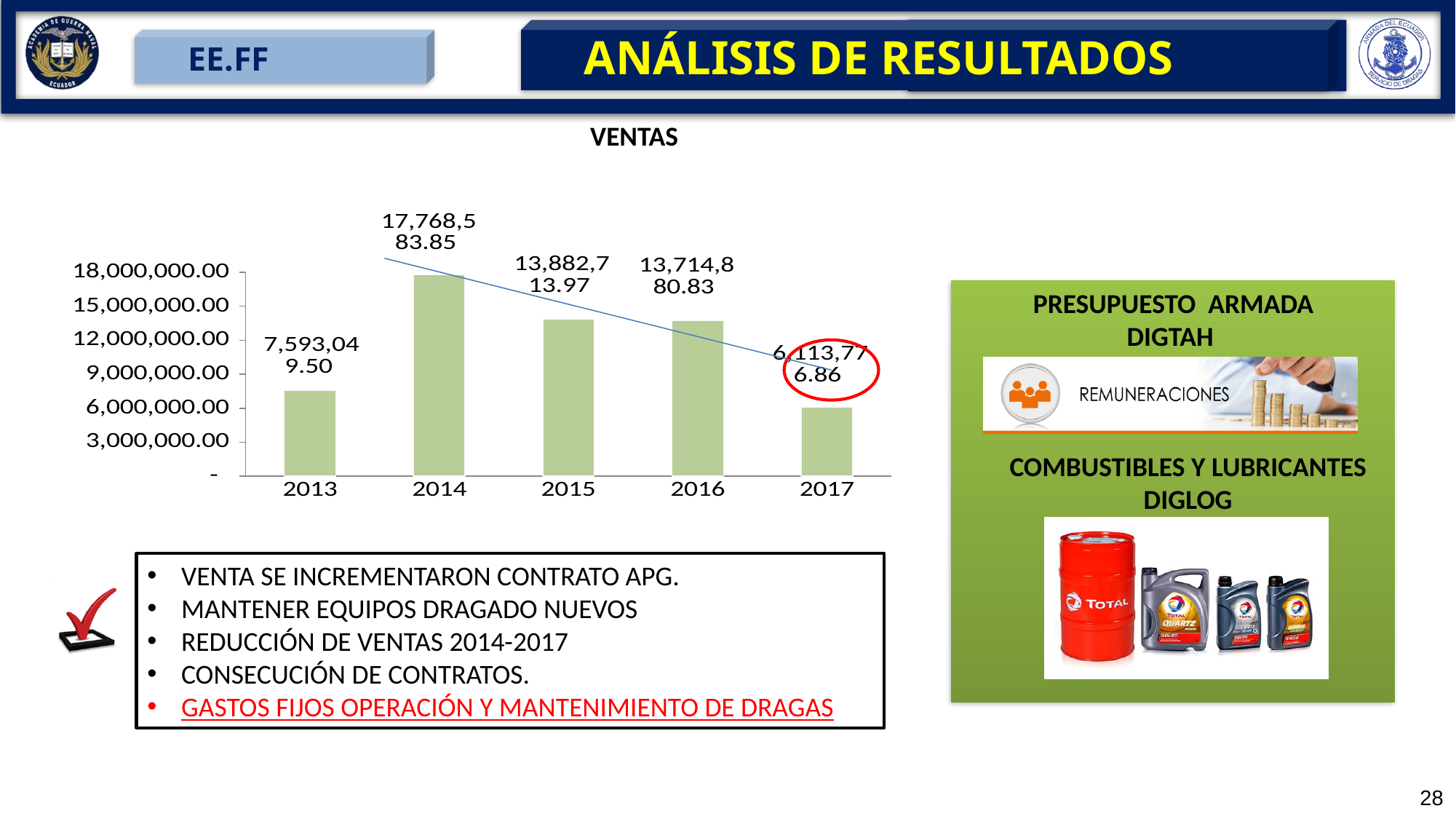
Do the values in the VENTAS chart rise or fall from 2014 to 2017? fall Is the value for 2013 in the VENTAS chart greater or less than 9,000,000.00? less How many years are shown on the x axis of the VENTAS chart? 5 What is the value for 2013 in the VENTAS chart? 7,593,049.50 What kind of chart is shown under the title VENTAS? bar chart In the VENTAS chart, which year has the larger value, 2015 or 2016? 2015 What is the title of the chart on the slide? VENTAS What is the value for 2016 in the VENTAS chart? 13,714,880.83 Which year has the highest value in the VENTAS chart? 2014 What is the difference between the 2014 and 2015 values in the VENTAS chart? 3,885,869.88 Which year has the lowest value in the VENTAS chart? 2017 What is the value for 2014 in the VENTAS chart? 17,768,583.85